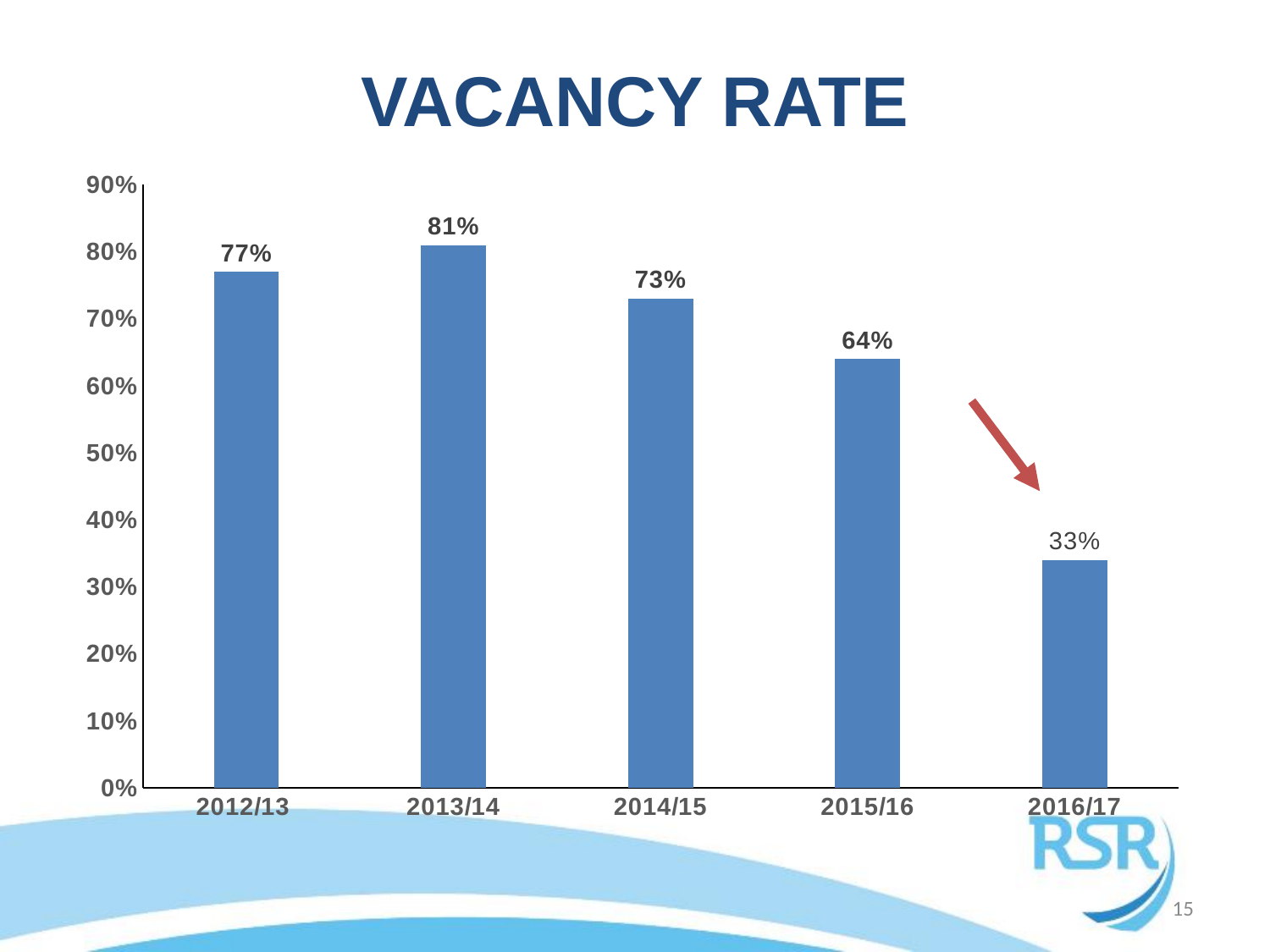
What is the difference in vacancy rate between 2013/14 and 2012/13? 4% Which year has a higher vacancy rate, 2014/15 or 2015/16? 2014/15 Which year has the lowest vacancy rate? 2016/17 Is the vacancy rate for 2015/16 greater or less than 60%? greater What kind of chart is shown on the slide? Bar chart What is the title of the chart? VACANCY RATE How many years are shown on the chart? 5 Which year has the highest vacancy rate? 2013/14 What is the vacancy rate for 2016/17? 33% What is the vacancy rate for 2012/13? 77% What is the difference in vacancy rate between 2015/16 and 2016/17? 31% What is the vacancy rate for 2014/15? 73%